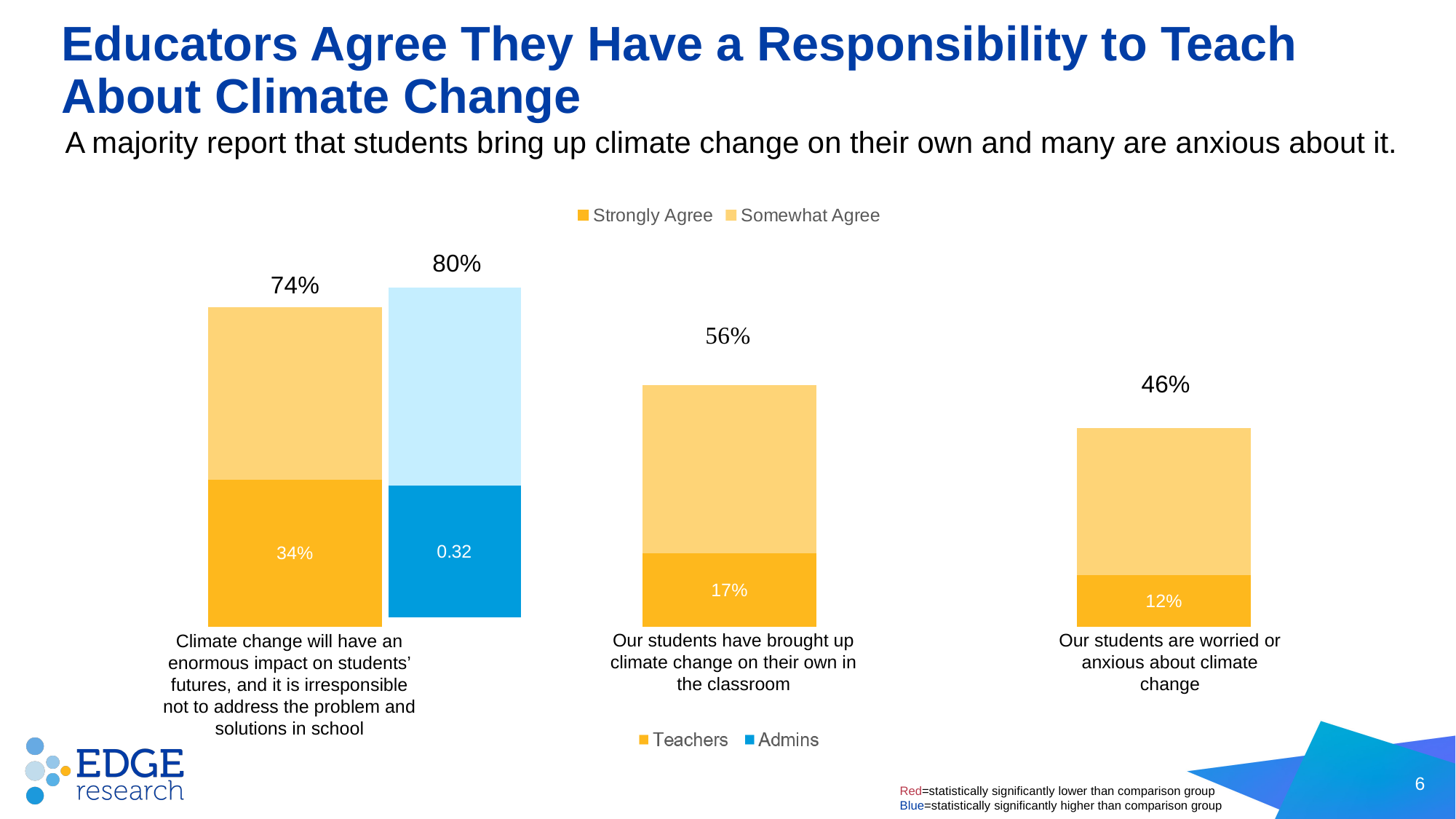
What is the difference between the total agreement of Teachers (74%) and Admins (80%) on the statement that climate change will have an enormous impact on students' futures? 6% What two agreement levels does the top legend list? Strongly Agree and Somewhat Agree What is the total agreement among Teachers that their students are worried or anxious about climate change? 46% What is the total agreement among Teachers that climate change will have an enormous impact on students' futures and it is irresponsible not to address it in school? 74% What percentage of Teachers strongly agree that their students have brought up climate change on their own in the classroom? 17% Which statement has the lowest total agreement among Teachers? Our students are worried or anxious about climate change For the statement that climate change will have an enormous impact on students' futures, is total agreement higher among Teachers or Admins? Admins What is the total agreement among Admins that climate change will have an enormous impact on students' futures and it is irresponsible not to address it in school? 80% What kind of chart is shown on the slide? Stacked bar chart How many statements are shown on the x axis of the chart? 3 What percentage of Teachers strongly agree that their students are worried or anxious about climate change? 12% Which statement has the highest total agreement among Teachers? Climate change will have an enormous impact on students' futures, and it is irresponsible not to address the problem and solutions in school